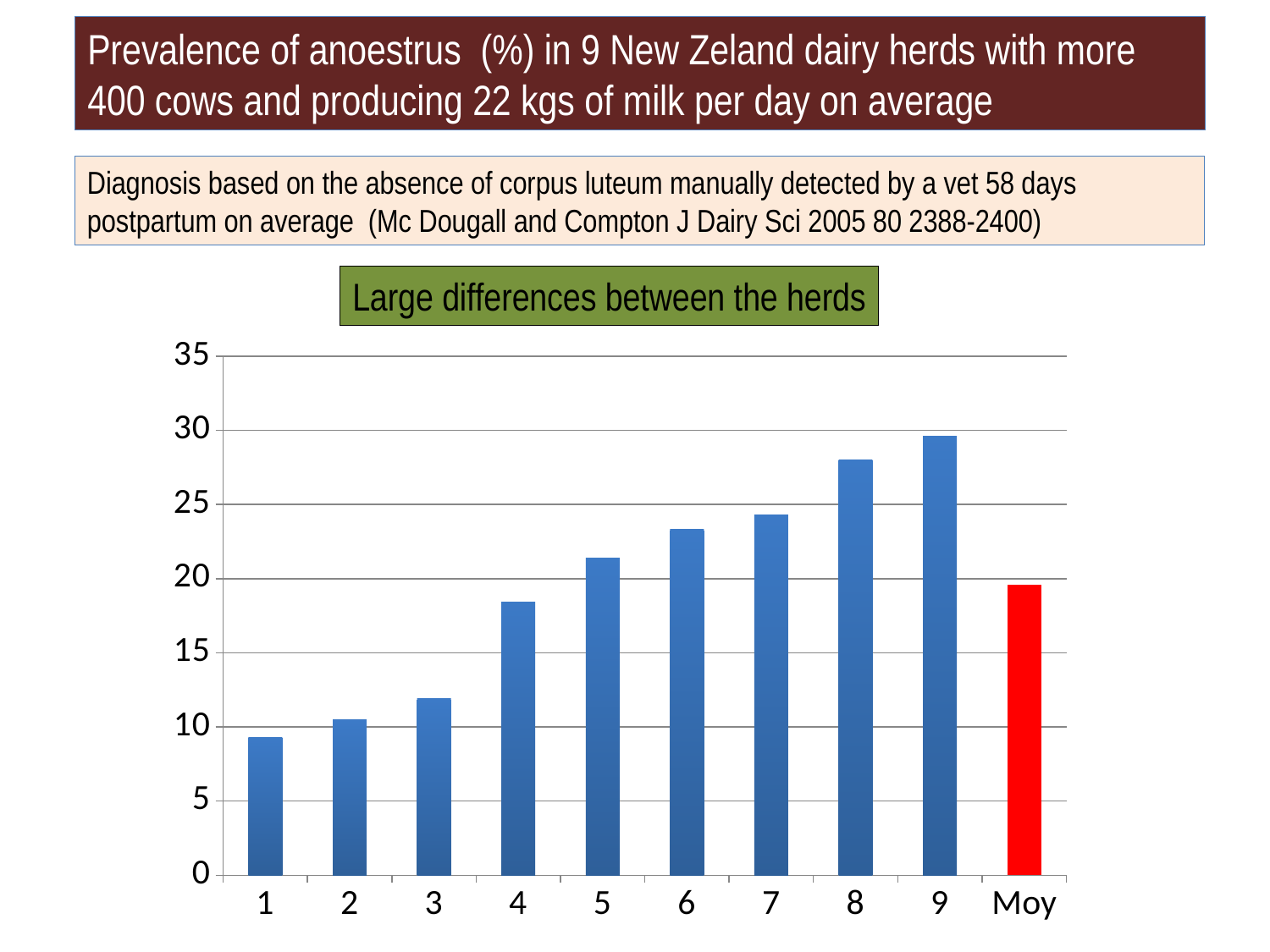
Is the value for herd 4 greater or less than 20? less What colour is the bar labelled Moy? red Is the value for herd 1 greater or less than 10? less Do the values for herds 1 through 9 rise or fall along the x axis? rise Is the value for herd 3 greater or less than 15? less Which is larger, the value for herd 8 or the value for herd 4? herd 8 What kind of chart is shown on the slide? bar chart Which herd has the highest prevalence of anoestrus? 9 How many bars are plotted on the chart? 10 Which herd has the lowest prevalence of anoestrus? 1